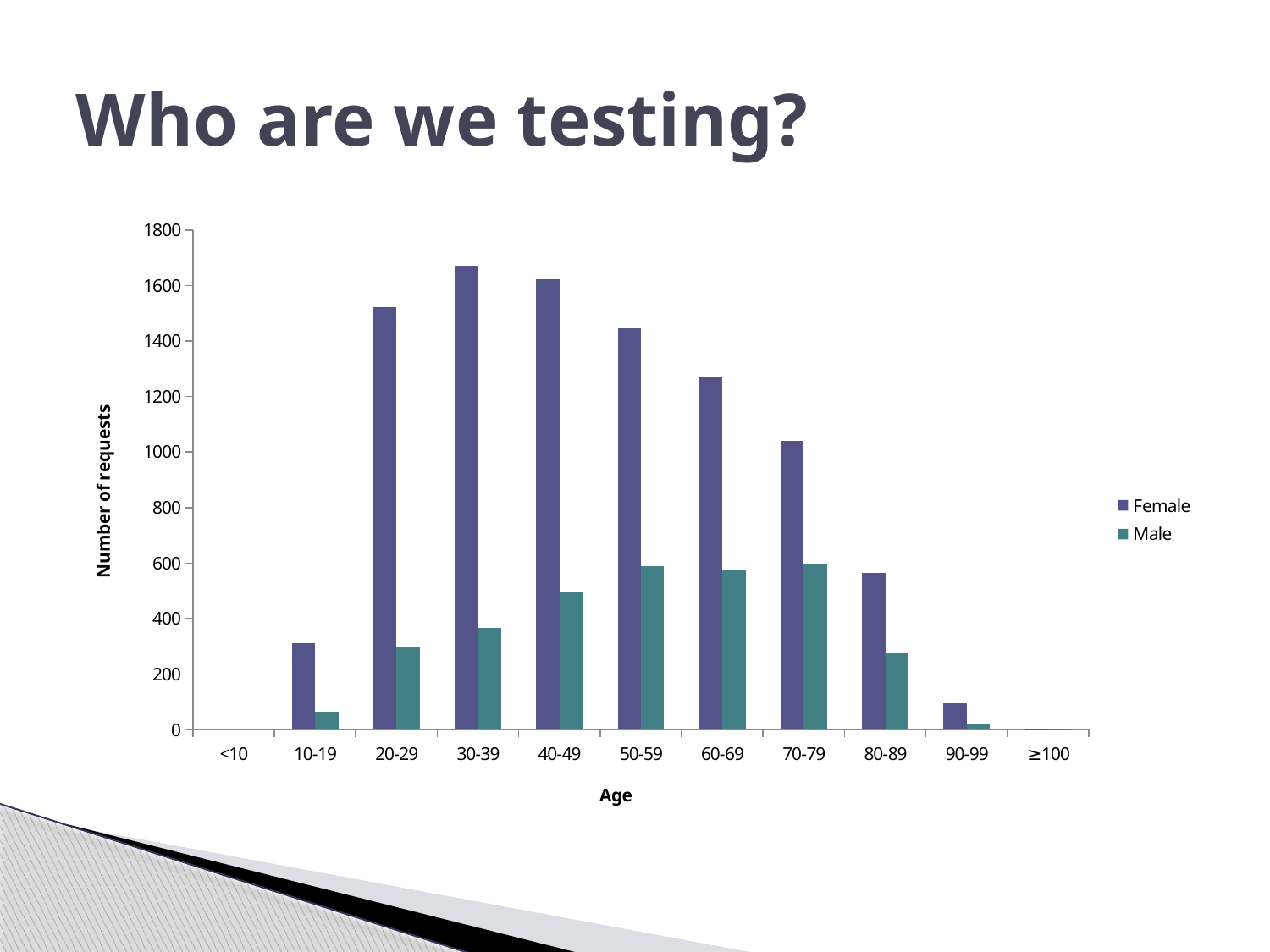
Which age group has the highest Female value? 30-39 Do the Female values rise or fall from 30-39 to 90-99? fall Is the Male value for 40-49 greater or less than 600? less How many series does the legend list? 2 What kind of chart is shown on the slide? bar chart Is the Female value for 70-79 greater or less than 1000? greater In the 40-49 age group, which is larger, the Female value or the Male value? Female How many age categories are shown on the x axis? 11 What is the label on the y axis? Number of requests Is the Female value for 20-29 greater or less than 1400? greater